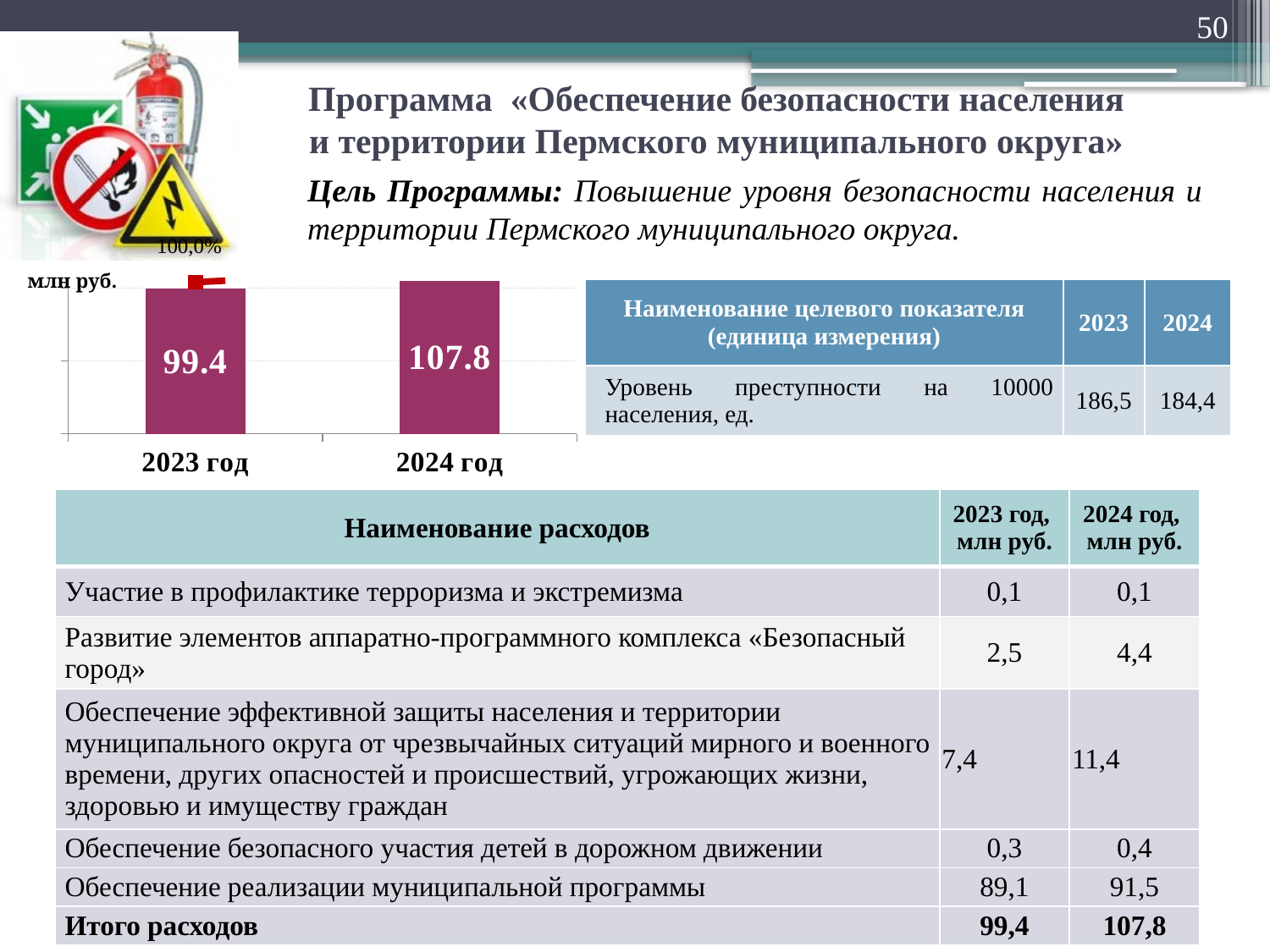
Which year has the highest value in the bar chart? 2024 год What is the difference between the values for 2024 год and 2023 год in the bar chart? 8.4 Which is larger in the bar chart, the value for 2023 год or for 2024 год? 2024 год What kind of chart is shown on the slide? bar chart Which year has the lowest value in the bar chart? 2023 год What is the value shown for 2023 год in the bar chart? 99.4 Do the values in the bar chart rise or fall from 2023 год to 2024 год? rise What is the value shown for 2024 год in the bar chart? 107.8 How many bars are shown in the bar chart? 2 What unit is indicated next to the bar chart's vertical axis? млн руб.